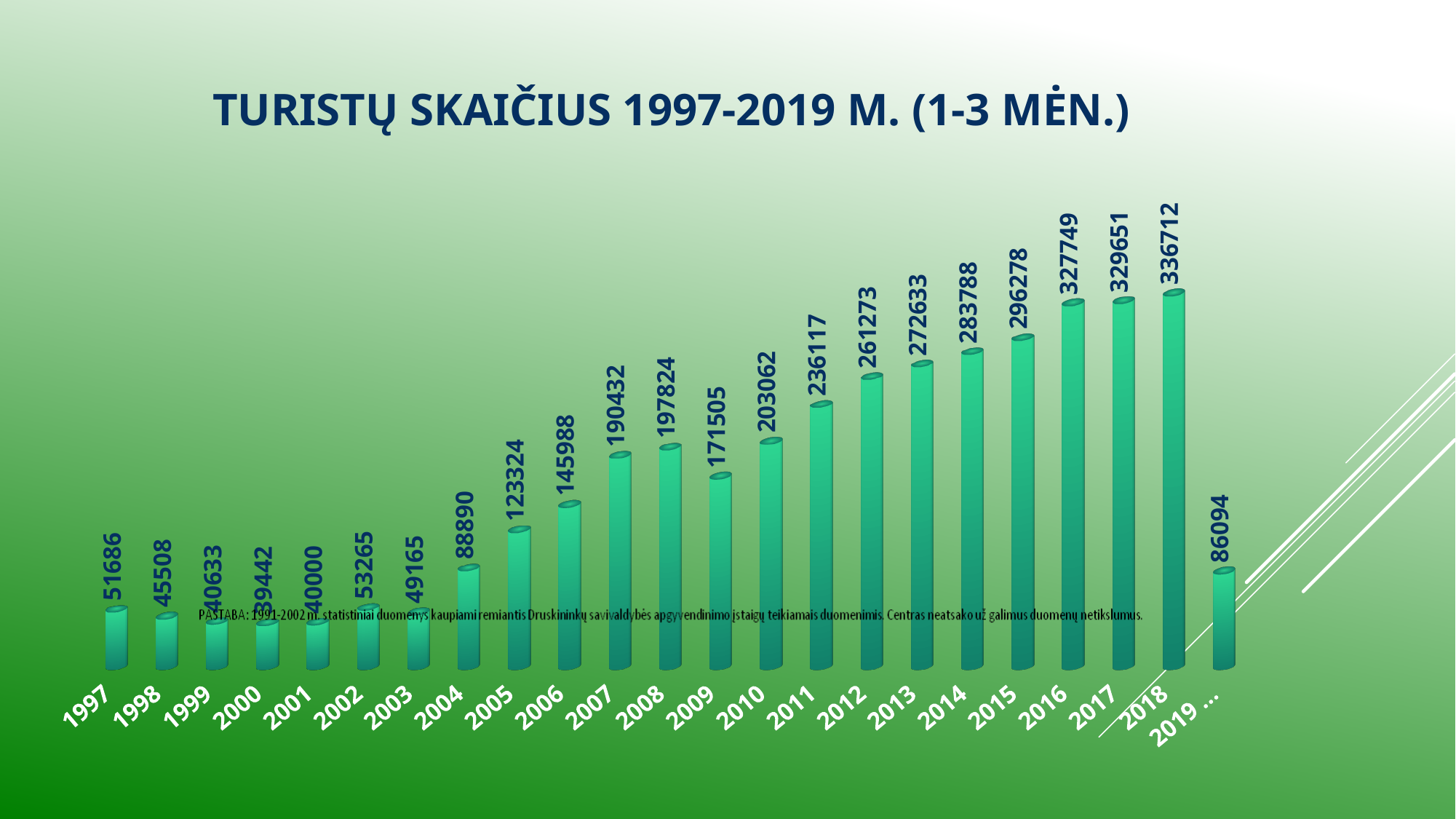
Which year has the lowest value? 2000 Which year has the highest value? 2018 What is the value for 2004? 88890 What is the title of the chart? TURISTŲ SKAIČIUS 1997-2019 M. (1-3 MĖN.) What is the value for 2011? 236117 What kind of chart is this? bar chart What is the value for 2019? 86094 How many years are shown on the x axis? 23 Which is larger, the value for 2009 or the value for 2010? 2010 What is the difference between the values for 2008 and 2009? 26319 What is the difference between the values for 2018 and 2017? 7061 Do the values generally rise or fall from 1997 to 2018? rise